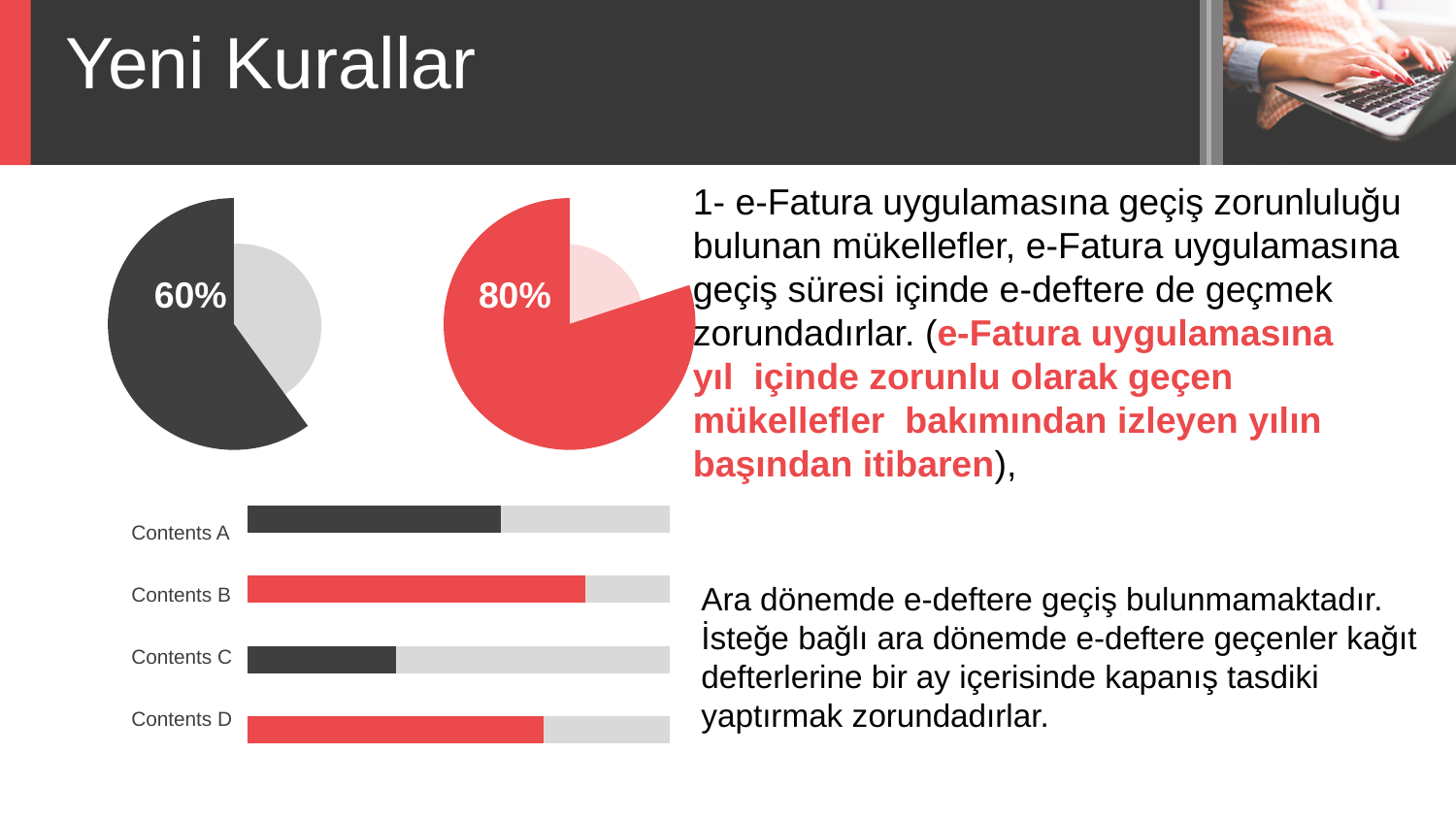
In the bar chart at the bottom left, which bar is longer, Contents A or Contents C? Contents A In the bar chart at the bottom left, which category has the longest bar? Contents B In the bar chart at the bottom left, what colour is the bar for Contents B? red In the left pie chart, what percentage is shown for the dark slice? 60% In the bar chart at the bottom left, which bar is longer, Contents B or Contents D? Contents B What is the difference between the percentage shown in the right pie chart and the percentage shown in the left pie chart? 20% In the bar chart at the bottom left, how many categories are shown? 4 In the bar chart at the bottom left, which category has the shortest bar? Contents C In the right pie chart, what percentage is shown for the red slice? 80% Which pie chart shows the larger highlighted share, the left one or the right one? the right one What type of chart is shown at the bottom left of the slide? bar chart How many pie charts are on the slide? 2